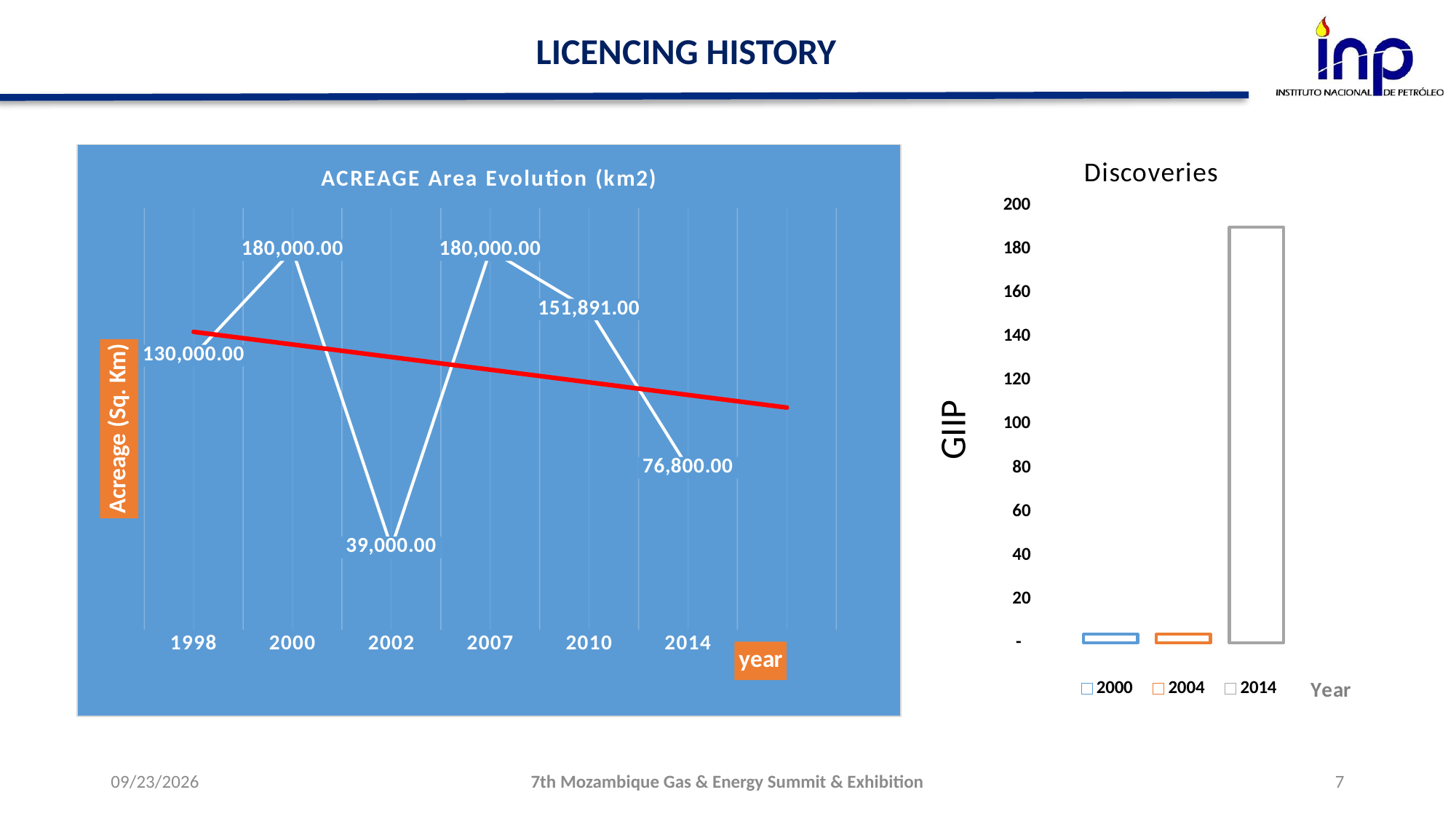
In the ACREAGE Area Evolution (km2) chart, what is the acreage value for 2002? 39,000.00 In the ACREAGE Area Evolution (km2) chart, how many years are plotted on the x axis? 6 In the Discoveries chart, which series has the highest GIIP value? 2014 In the ACREAGE Area Evolution (km2) chart, which year has the lowest acreage value? 2002 In the Discoveries chart, how many series does the legend list? 3 What kind of chart is the ACREAGE Area Evolution (km2) chart? Line chart In the ACREAGE Area Evolution (km2) chart, which is larger, the value for 1998 or the value for 2014? 1998 In the ACREAGE Area Evolution (km2) chart, does the acreage rise or fall from 2007 to 2014? Fall In the ACREAGE Area Evolution (km2) chart, what is the difference between the 2010 value and the 2014 value? 75,091.00 In the ACREAGE Area Evolution (km2) chart, what is the acreage value for 1998? 130,000.00 In the ACREAGE Area Evolution (km2) chart, what is the acreage value for 2010? 151,891.00 In the Discoveries chart, is the GIIP value for 2014 greater or less than 160? greater